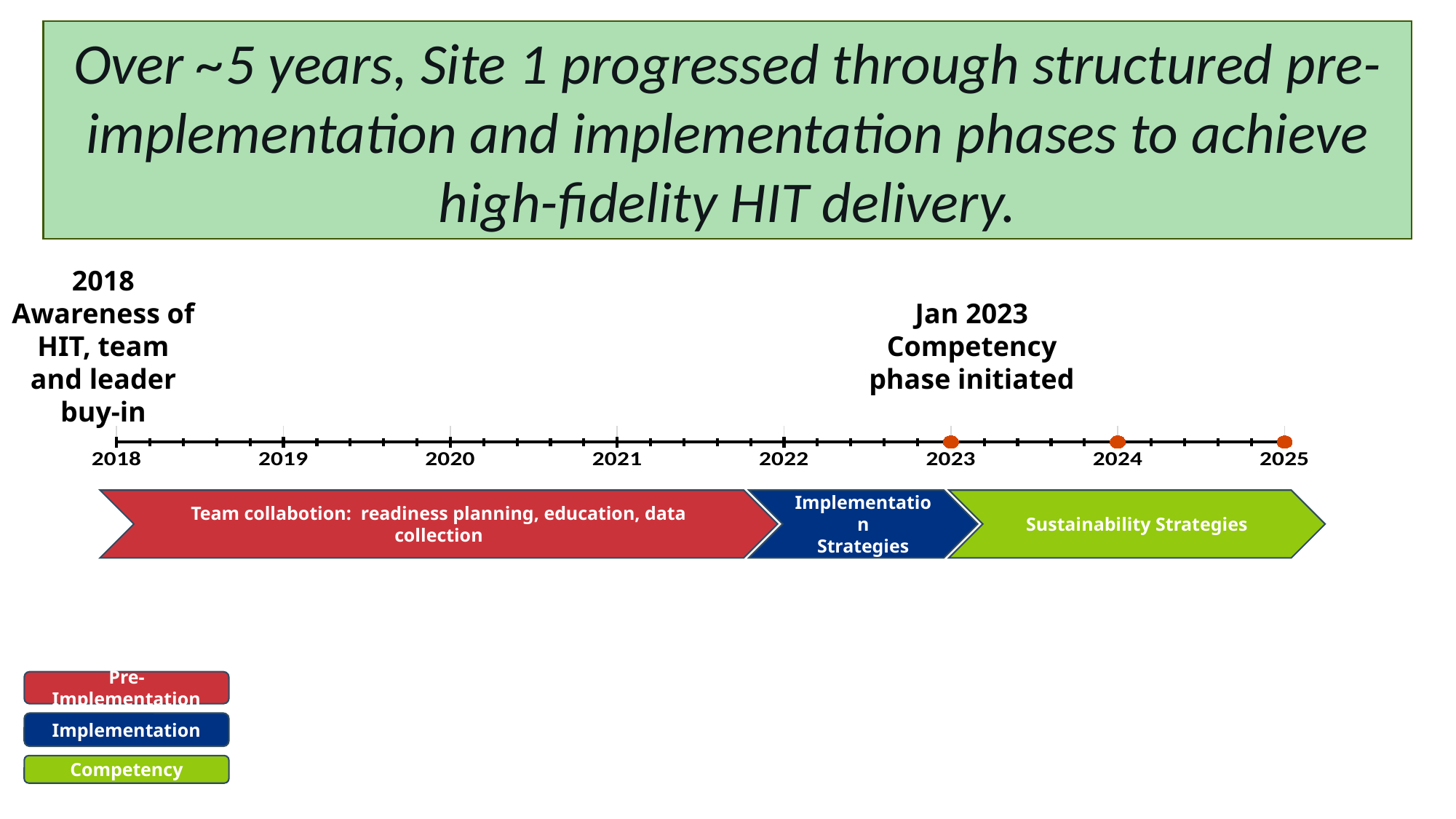
When was the Competency phase initiated according to the timeline annotation? Jan 2023 Which colour represents the Implementation phase in the legend? blue What is the first year shown on the timeline axis? 2018 How many phases does the legend list? 3 What milestone is annotated at 2018 on the timeline? Awareness of HIT, team and leader buy-in Which phase does the red arrow labelled 'Team collabotion: readiness planning, education, data collection' represent? Pre-Implementation How many year labels are marked along the timeline axis? 8 How many orange marker dots are placed on the timeline axis? 3 Which phase arrow is labelled 'Sustainability Strategies'? Competency What is the last year shown on the timeline axis? 2025 Which colour represents the Competency phase in the legend? green What kind of chart is shown on the slide? timeline